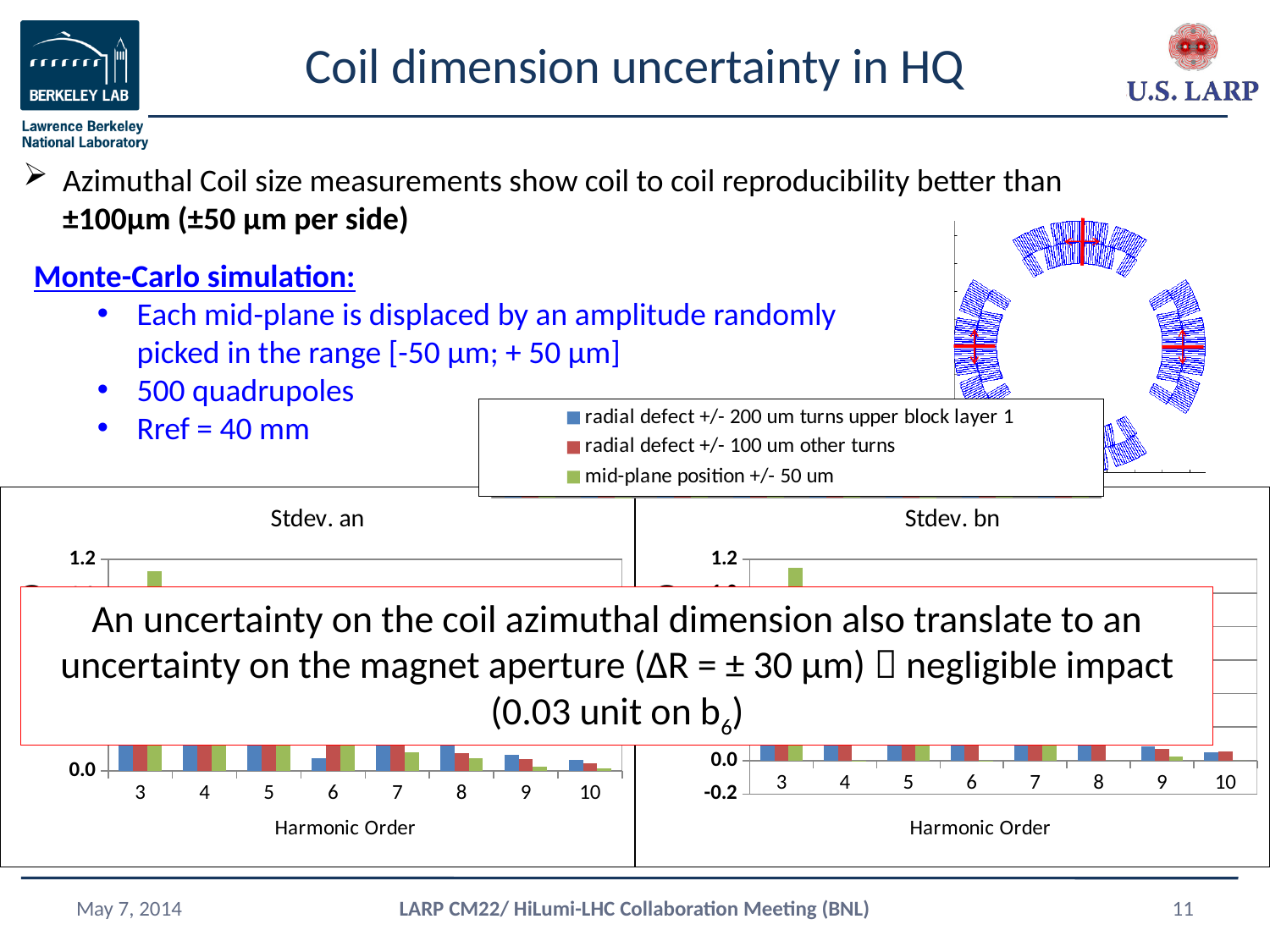
How many series does the legend above the charts list? 3 In the 'Stdev. bn' chart, which series has the tallest bar overall? mid-plane position +/- 50 um Which legend entry is shown in green? mid-plane position +/- 50 um What is the x-axis title of the 'Stdev. an' chart? Harmonic Order What type of chart is the 'Stdev. an' chart? bar chart What is the lowest y-axis tick label shown on the 'Stdev. bn' chart? -0.2 How many harmonic orders are shown on the x axis of the 'Stdev. bn' chart? 8 In the 'Stdev. an' chart, at harmonic order 10, which is larger: the blue bar or the green bar? the blue bar In the 'Stdev. an' chart, at which harmonic order is the tallest bar? 3 In the 'Stdev. bn' chart, at harmonic order 9, which is larger: the blue bar or the green bar? the blue bar In the 'Stdev. an' chart, do the green bars rise or fall from harmonic order 8 to 10? fall In the 'Stdev. an' chart, is the green bar at harmonic order 3 greater or less than 1.2? less